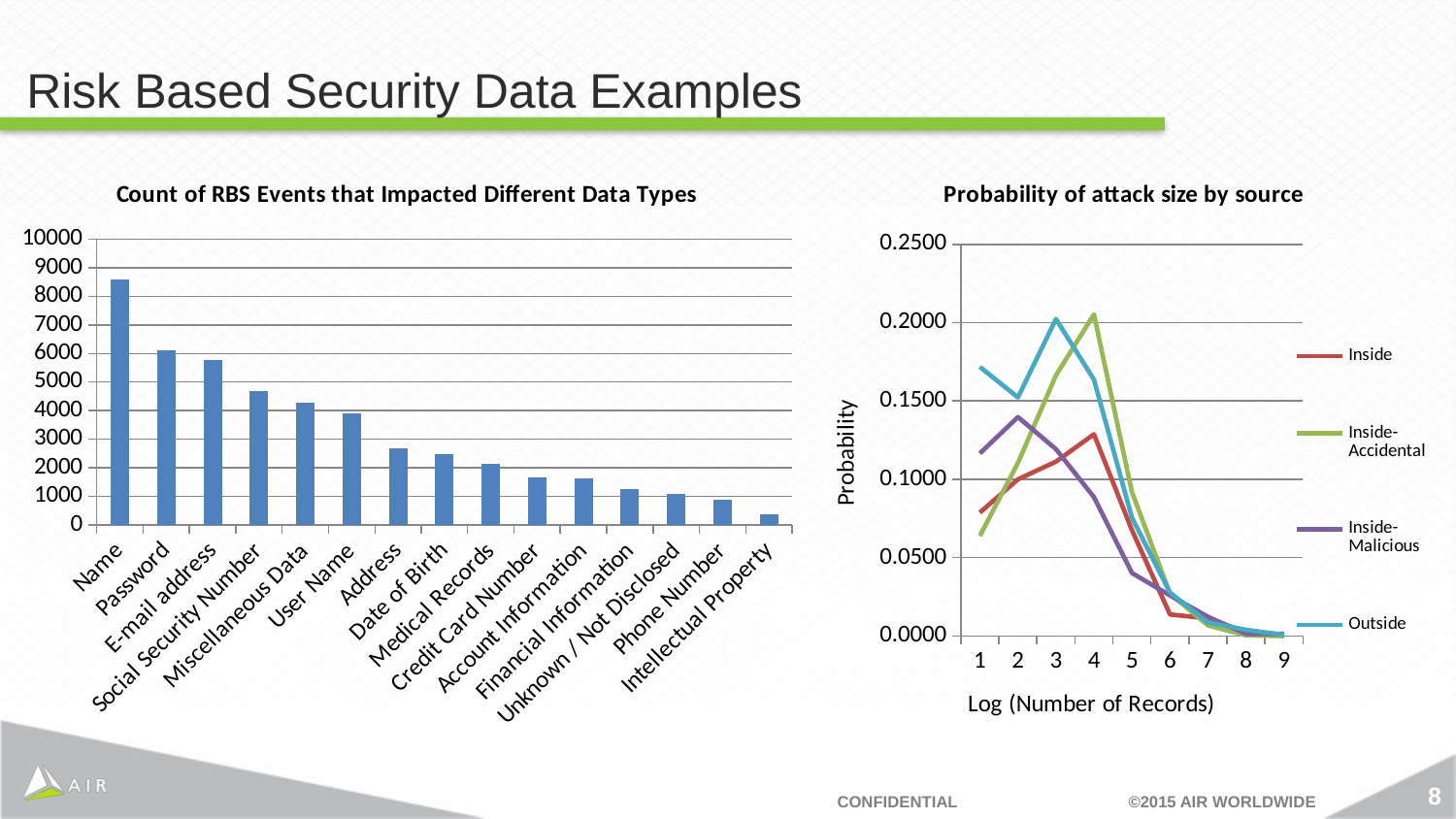
What kind of chart is the 'Count of RBS Events that Impacted Different Data Types' chart? bar chart In the 'Count of RBS Events that Impacted Different Data Types' chart, do the values rise or fall from left to right? fall In the 'Count of RBS Events that Impacted Different Data Types' chart, is the value for Intellectual Property greater or less than 1000? less In the 'Count of RBS Events that Impacted Different Data Types' chart, which data type has the lowest count? Intellectual Property In the 'Count of RBS Events that Impacted Different Data Types' chart, is the value for Address greater or less than 3000? less In the 'Count of RBS Events that Impacted Different Data Types' chart, which is larger, the count for Password or the count for User Name? Password How many data types are shown in the 'Count of RBS Events that Impacted Different Data Types' chart? 15 In the 'Probability of attack size by source' chart, which series has the highest probability at Log (Number of Records) = 1? Outside In the 'Count of RBS Events that Impacted Different Data Types' chart, which data type has the highest count? Name How many series does the legend of the 'Probability of attack size by source' chart list? 4 In the 'Count of RBS Events that Impacted Different Data Types' chart, is the value for Name greater or less than 8000? greater What kind of chart is the 'Probability of attack size by source' chart? line chart